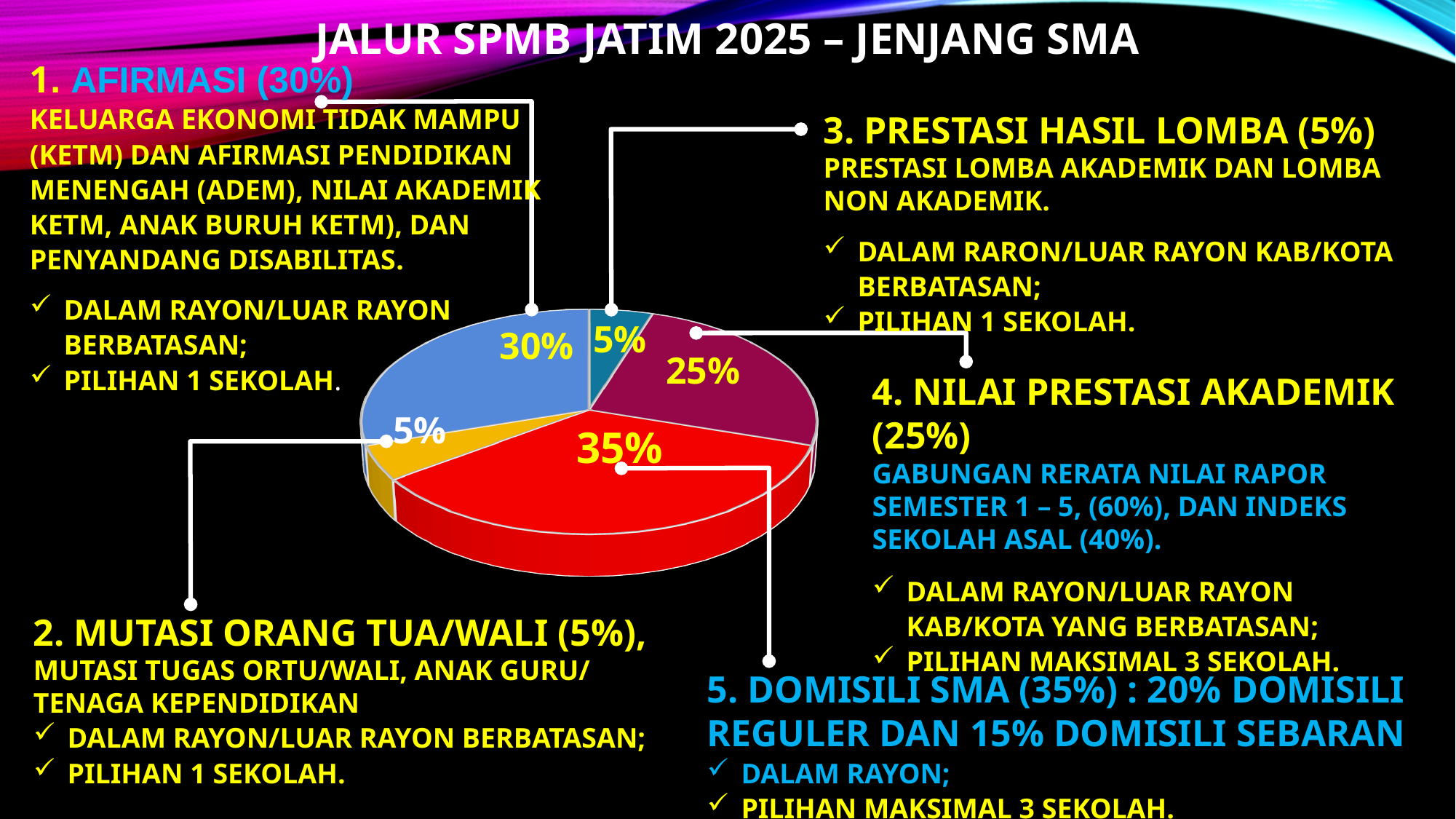
What is the difference between the NILAI PRESTASI AKADEMIK share and the PRESTASI HASIL LOMBA share? 20% Which is larger, the slice for AFIRMASI or the slice for NILAI PRESTASI AKADEMIK? AFIRMASI What share of the pie does MUTASI ORANG TUA/WALI have? 5% What colour is the DOMISILI SMA slice of the pie? red How many slices does the pie chart have? 5 What share of the pie does AFIRMASI have? 30% What share of the pie does PRESTASI HASIL LOMBA have? 5% What is the difference between the DOMISILI SMA share and the AFIRMASI share? 5% What kind of chart is shown on the slide? pie chart Which category has the largest slice of the pie? DOMISILI SMA